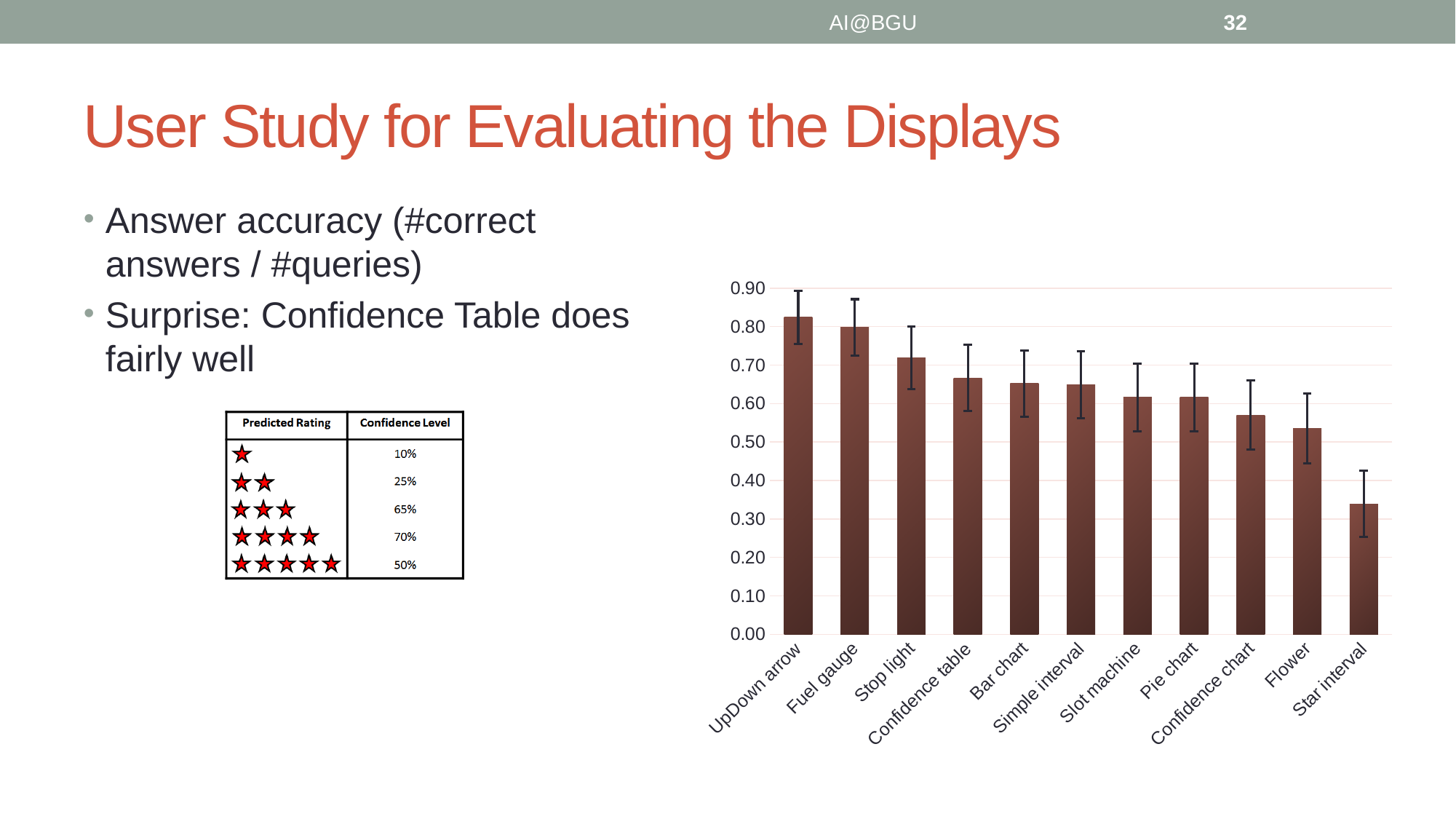
Which has the larger value, Stop light or Flower? Stop light Is the value for Star interval greater or less than 0.40? less Is the value for Confidence chart greater or less than 0.60? less Which display has the highest bar in the chart? UpDown arrow Is the value for Confidence table greater or less than 0.70? less What kind of chart is shown on the slide? bar chart Which display has the lowest bar in the chart? Star interval How many display types (categories) are plotted in the bar chart? 11 What is the highest tick value shown on the y axis of the chart? 0.90 Do the bar values rise or fall from left to right along the x axis? fall